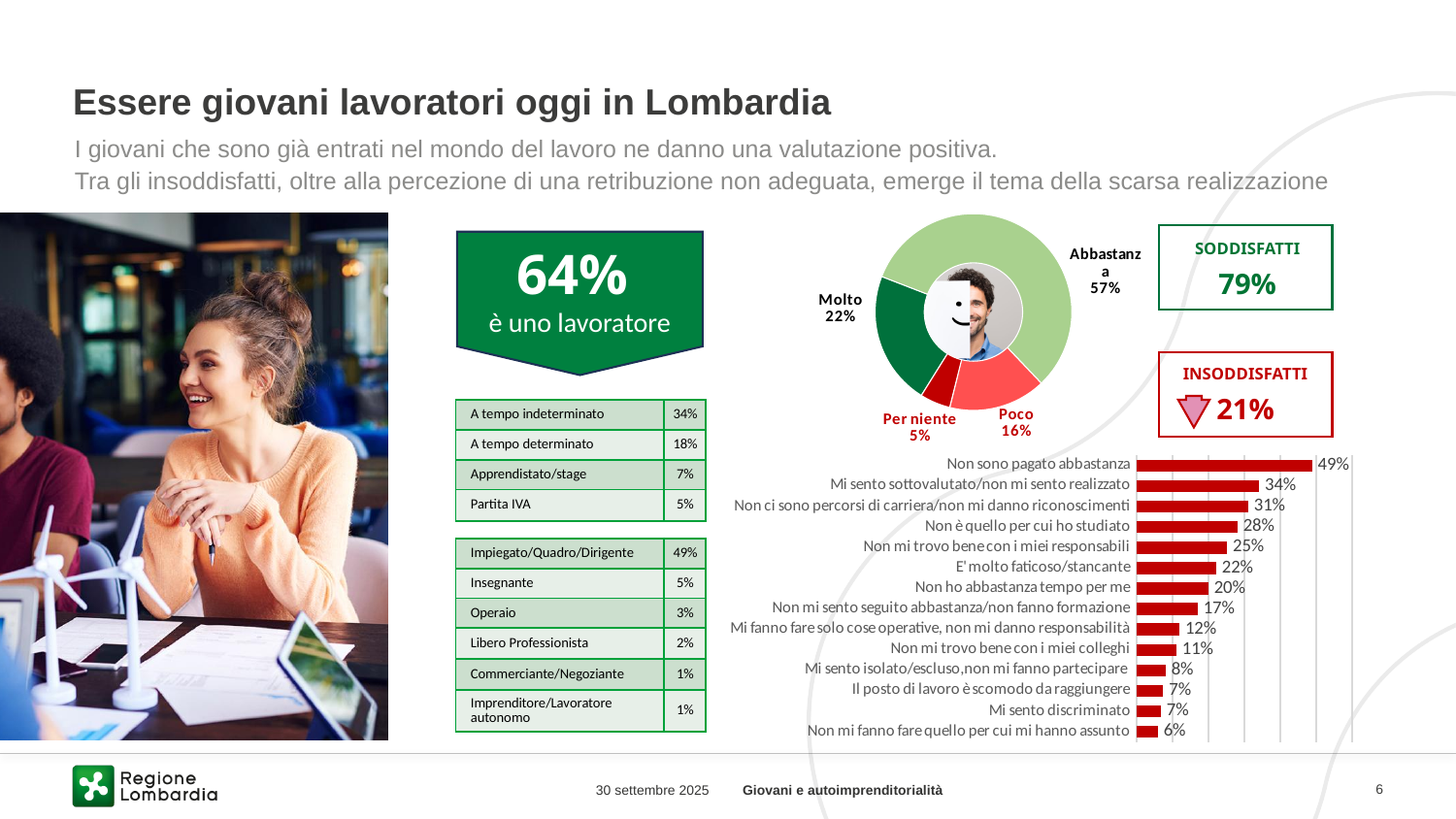
In the bar chart of reasons for dissatisfaction, what is the value for "Non è quello per cui ho studiato"? 28% In the pie chart of satisfaction levels, which slice is the largest? Abbastanza In the bar chart of reasons for dissatisfaction, what is the difference between "Mi sento sottovalutato/non mi sento realizzato" and "Non ho abbastanza tempo per me"? 14% What kind of chart is used to show the satisfaction levels (Molto, Abbastanza, Poco, Per niente)? Doughnut chart In the bar chart of reasons for dissatisfaction, which category has the highest value? Non sono pagato abbastanza How many categories are shown in the bar chart of reasons for dissatisfaction? 14 In the bar chart of reasons for dissatisfaction, which category has the lowest value? Non mi fanno fare quello per cui mi hanno assunto What kind of chart is used to show the reasons for dissatisfaction? Bar chart In the bar chart of reasons for dissatisfaction, which is larger: "E' molto faticoso/stancante" or "Non mi sento seguito abbastanza/non fanno formazione"? E' molto faticoso/stancante In the bar chart of reasons for dissatisfaction, what is the value for "Non sono pagato abbastanza"? 49% In the pie chart of satisfaction levels, what is the share for "Abbastanza"? 57% In the pie chart of satisfaction levels, what is the share for "Per niente"? 5%